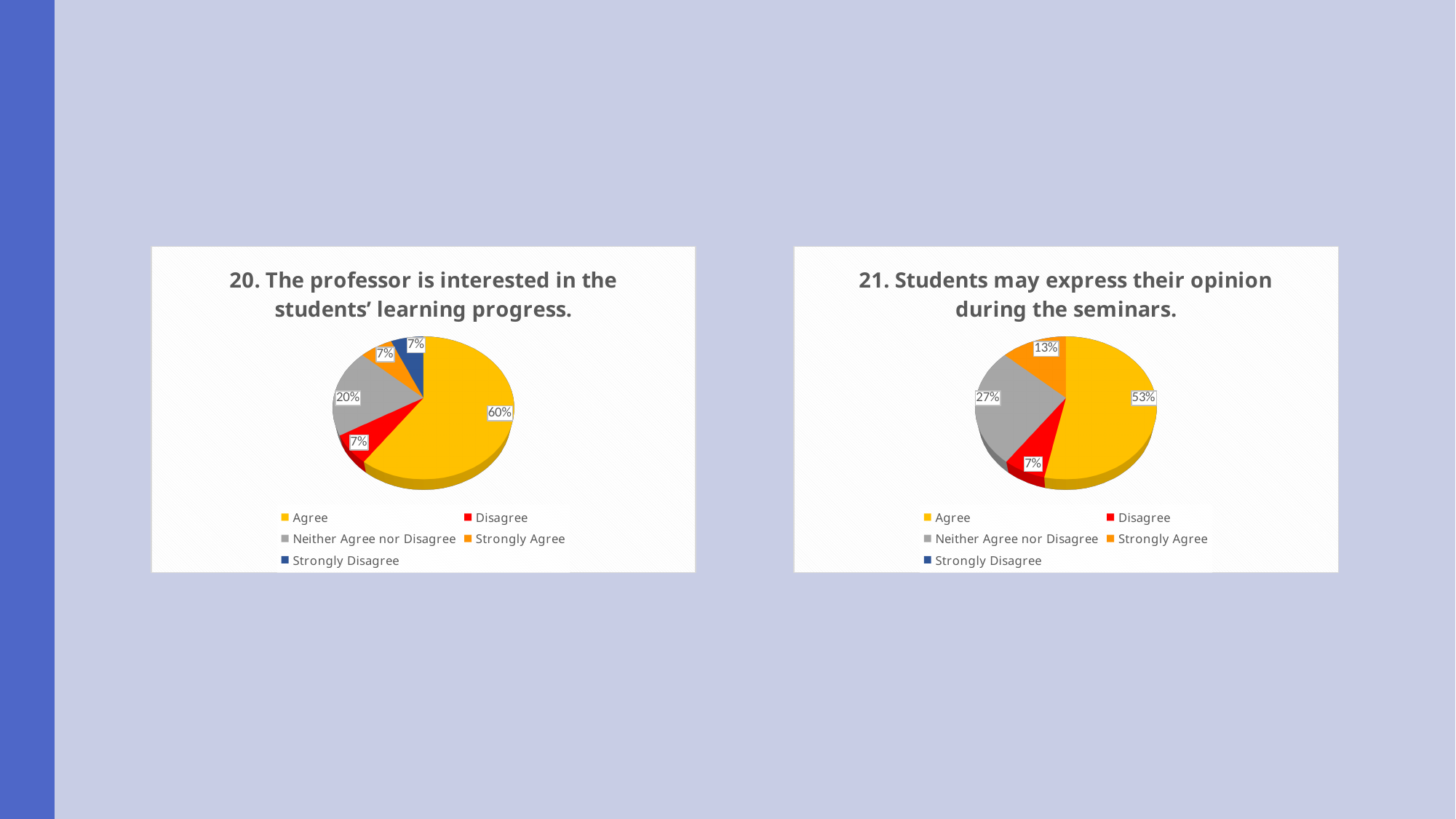
In the chart titled "20. The professor is interested in the students' learning progress.", what is the difference between the Agree share and the Neither Agree nor Disagree share? 40% In the chart titled "21. Students may express their opinion during the seminars.", what is the difference between the Agree share and the Neither Agree nor Disagree share? 26% In the chart titled "21. Students may express their opinion during the seminars.", what share of responses is Agree? 53% How many entries does the legend list in the chart titled "20. The professor is interested in the students' learning progress."? 5 In the chart titled "21. Students may express their opinion during the seminars.", which is larger: the Neither Agree nor Disagree share or the Strongly Agree share? Neither Agree nor Disagree In the chart titled "21. Students may express their opinion during the seminars.", what share of responses is Strongly Agree? 13% In the chart titled "20. The professor is interested in the students' learning progress.", which response has the largest share? Agree What type of chart is used on the left side of the slide? Pie chart In the chart titled "21. Students may express their opinion during the seminars.", which response has the smallest visible slice? Disagree In the chart titled "21. Students may express their opinion during the seminars.", what share of responses is Neither Agree nor Disagree? 27% In the chart titled "20. The professor is interested in the students' learning progress.", what share of responses is Neither Agree nor Disagree? 20% In the chart titled "20. The professor is interested in the students' learning progress.", what share of responses is Agree? 60%